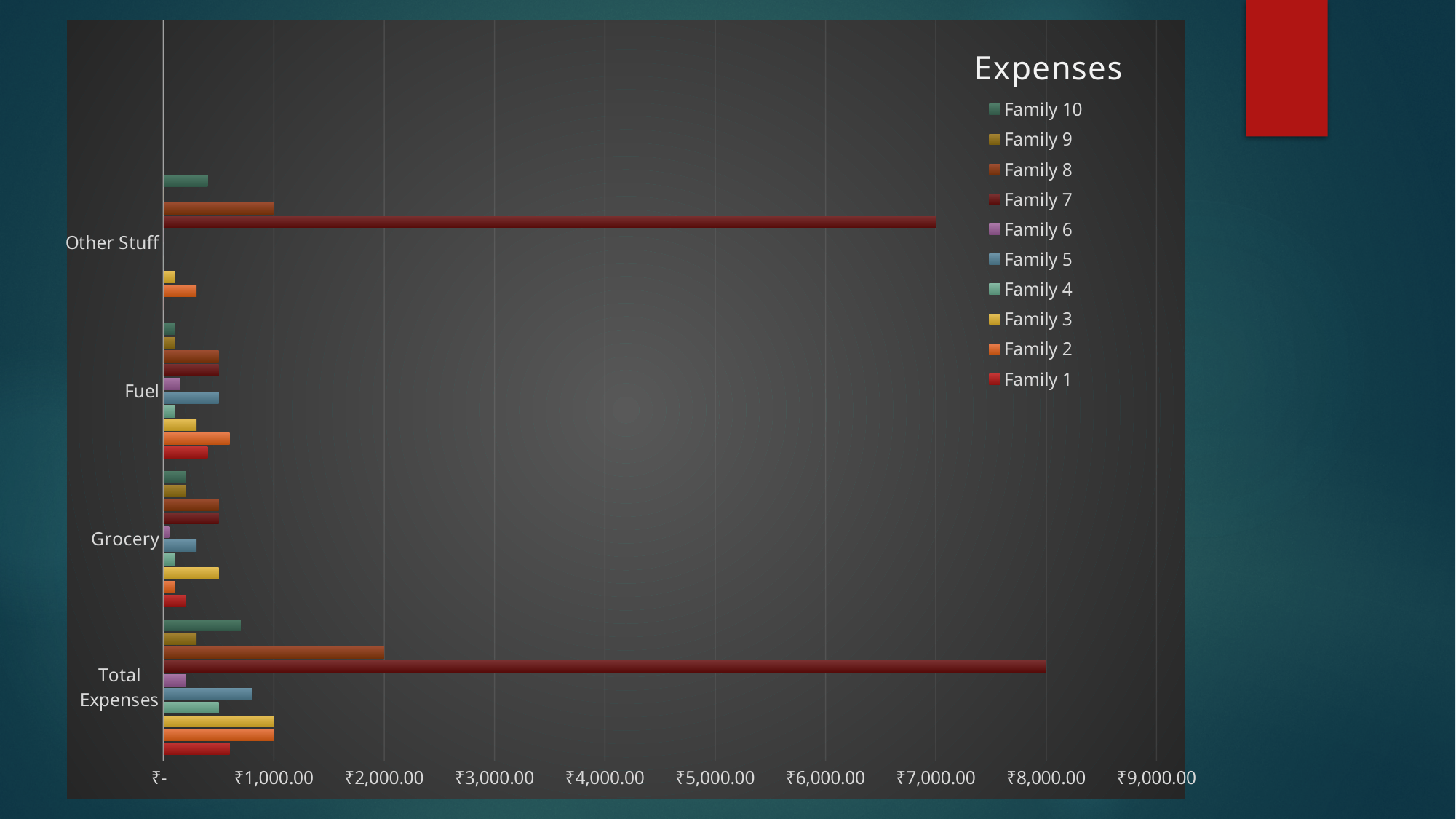
How many series does the legend of the Expenses chart list? 10 Is the Total Expenses value for Family 10 greater or less than ₹1,000.00? less What kind of chart is shown on the slide? bar chart What is the Total Expenses value for Family 8? ₹2,000.00 What is the difference between Family 7's and Family 8's Total Expenses? ₹6,000.00 What is the Total Expenses value for Family 7? ₹8,000.00 Which family has the highest Other Stuff expense? Family 7 What is the Other Stuff value for Family 7? ₹7,000.00 Which is larger in Total Expenses: Family 7 or Family 8? Family 7 What is the title of the chart? Expenses How many categories are shown on the vertical axis of the Expenses chart? 4 Which family has the highest Total Expenses? Family 7